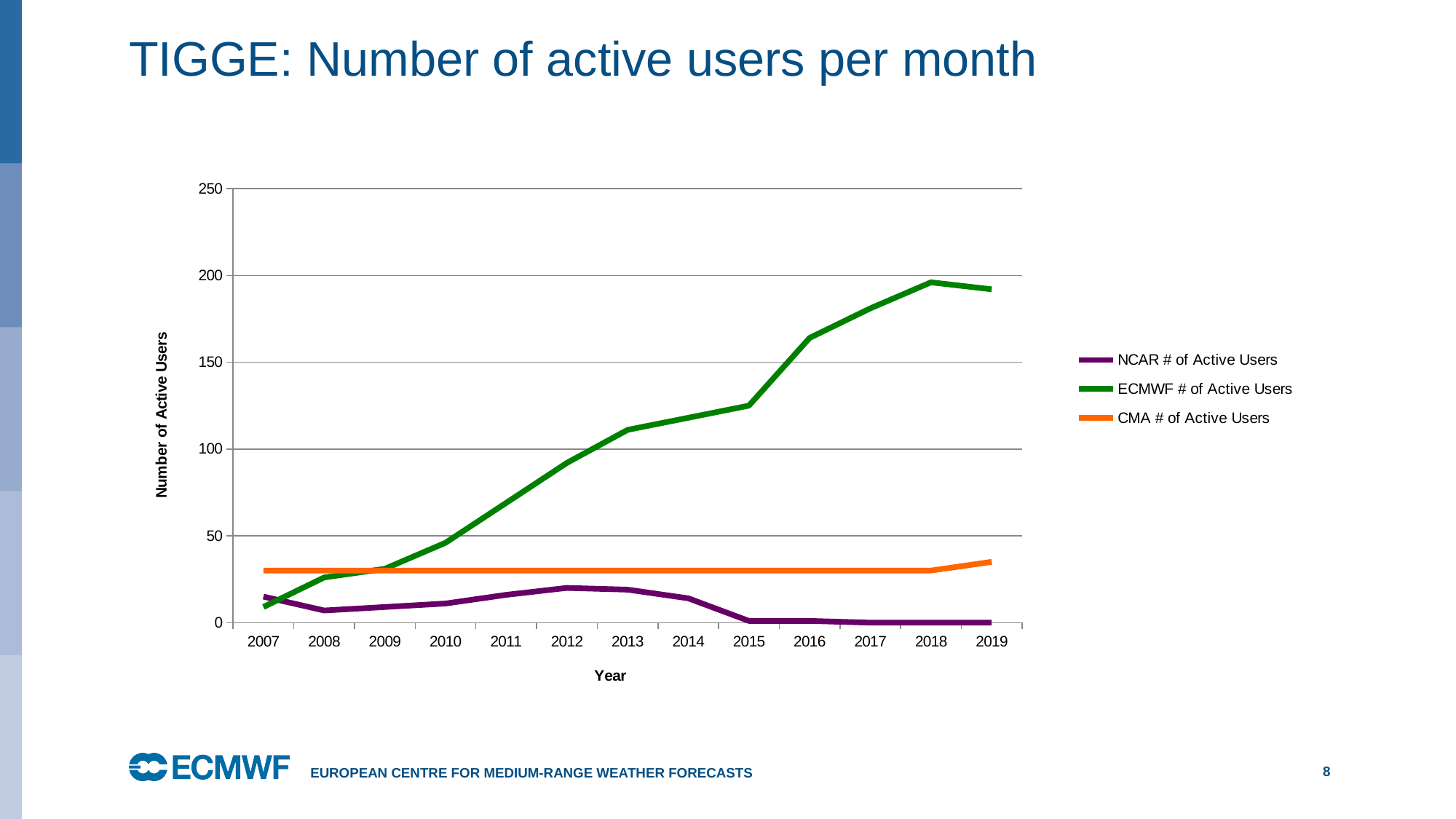
In 2019, which series has the larger value: ECMWF # of Active Users or CMA # of Active Users? ECMWF # of Active Users Is the value for ECMWF # of Active Users in 2016 greater or less than 150? greater Is the value for CMA # of Active Users in 2012 greater or less than 50? less What kind of chart is shown on the slide? line chart In which year is the ECMWF # of Active Users series at its lowest? 2007 How many series does the legend list? 3 Is the value for NCAR # of Active Users in 2008 greater or less than 50? less Does the ECMWF # of Active Users series generally rise or fall from 2007 to 2018? rise Which colour is used for the CMA # of Active Users line? orange How many years are shown along the x axis? 13 What is the title of the y axis? Number of Active Users